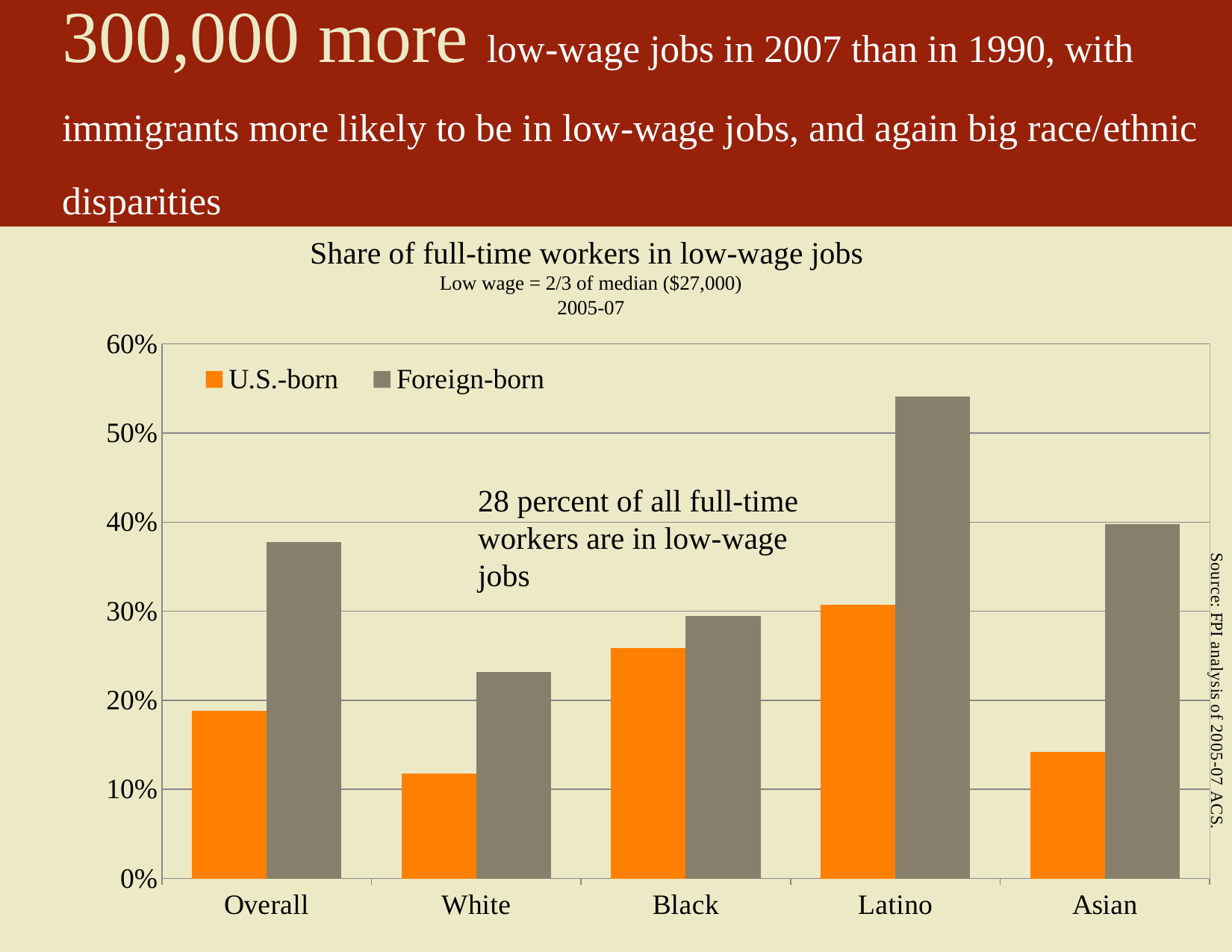
How many categories are shown on the x axis? 5 For Asian, which is larger: the U.S.-born value or the Foreign-born value? Foreign-born Which category has the highest Foreign-born value? Latino Which series is shown in orange in the legend? U.S.-born Is the U.S.-born value for White greater or less than 20%? less Which category has the lowest U.S.-born value? White How many series does the legend list? 2 Which category has the highest U.S.-born value? Latino What kind of chart is shown on the slide? bar chart Which category has the lowest Foreign-born value? White Is the U.S.-born value for Black greater or less than 20%? greater Is the Foreign-born value for Latino greater or less than 50%? greater